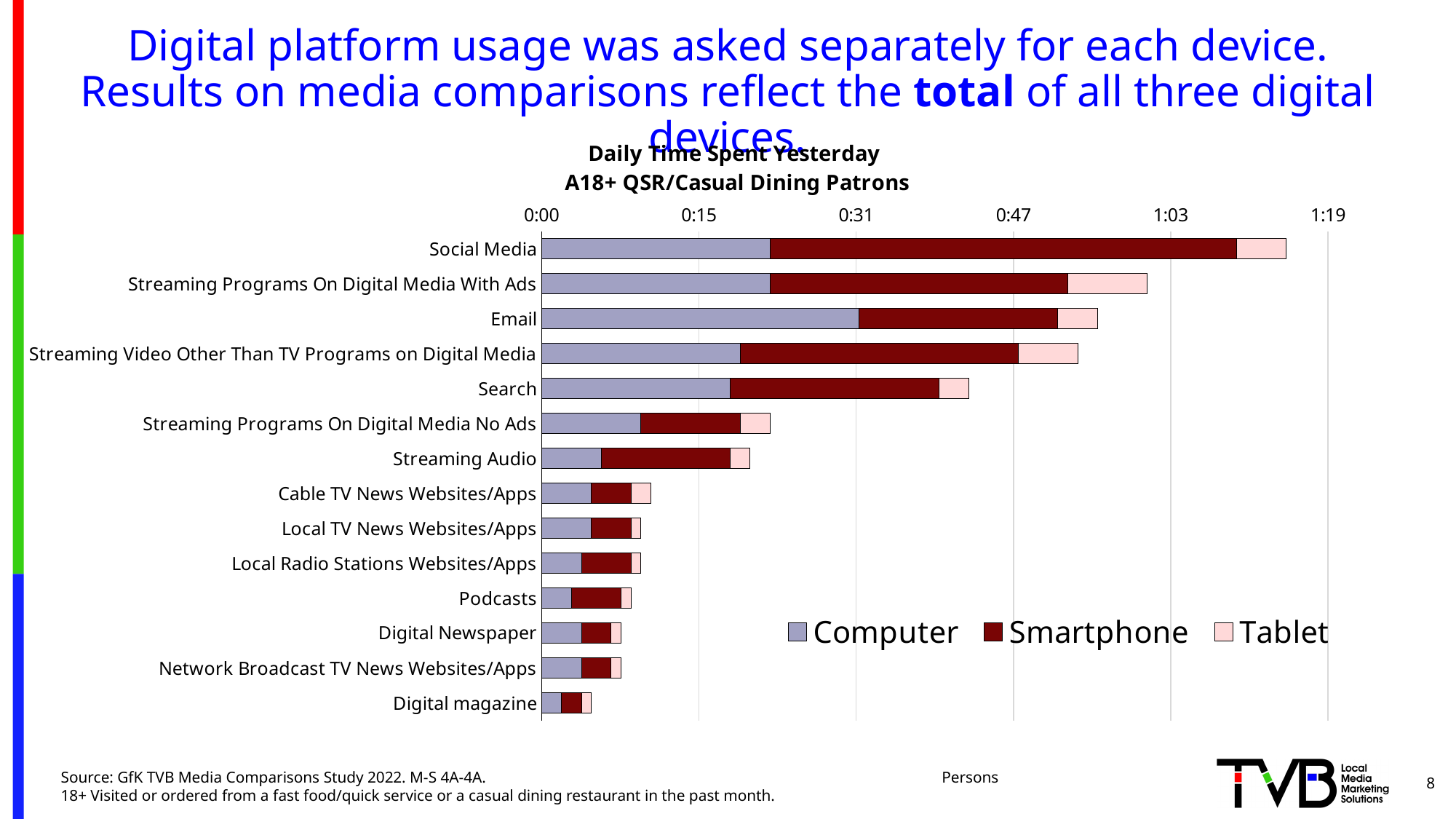
Which series is shown in the darkest red colour in the legend? Smartphone Is the total value for Cable TV News Websites/Apps greater or less than 0:15? less How many series does the legend list? 3 Is the total value for Social Media greater or less than 1:03? greater Is the total value for Email greater or less than 0:47? greater What kind of chart is shown on the slide? Stacked bar chart Which category has the shortest total bar? Digital magazine Which category has the longest total bar? Social Media How many categories are plotted on the chart? 14 Do the total bar lengths increase or decrease going down the chart from Social Media to Digital magazine? decrease Which has a larger total bar, Search or Streaming Audio? Search